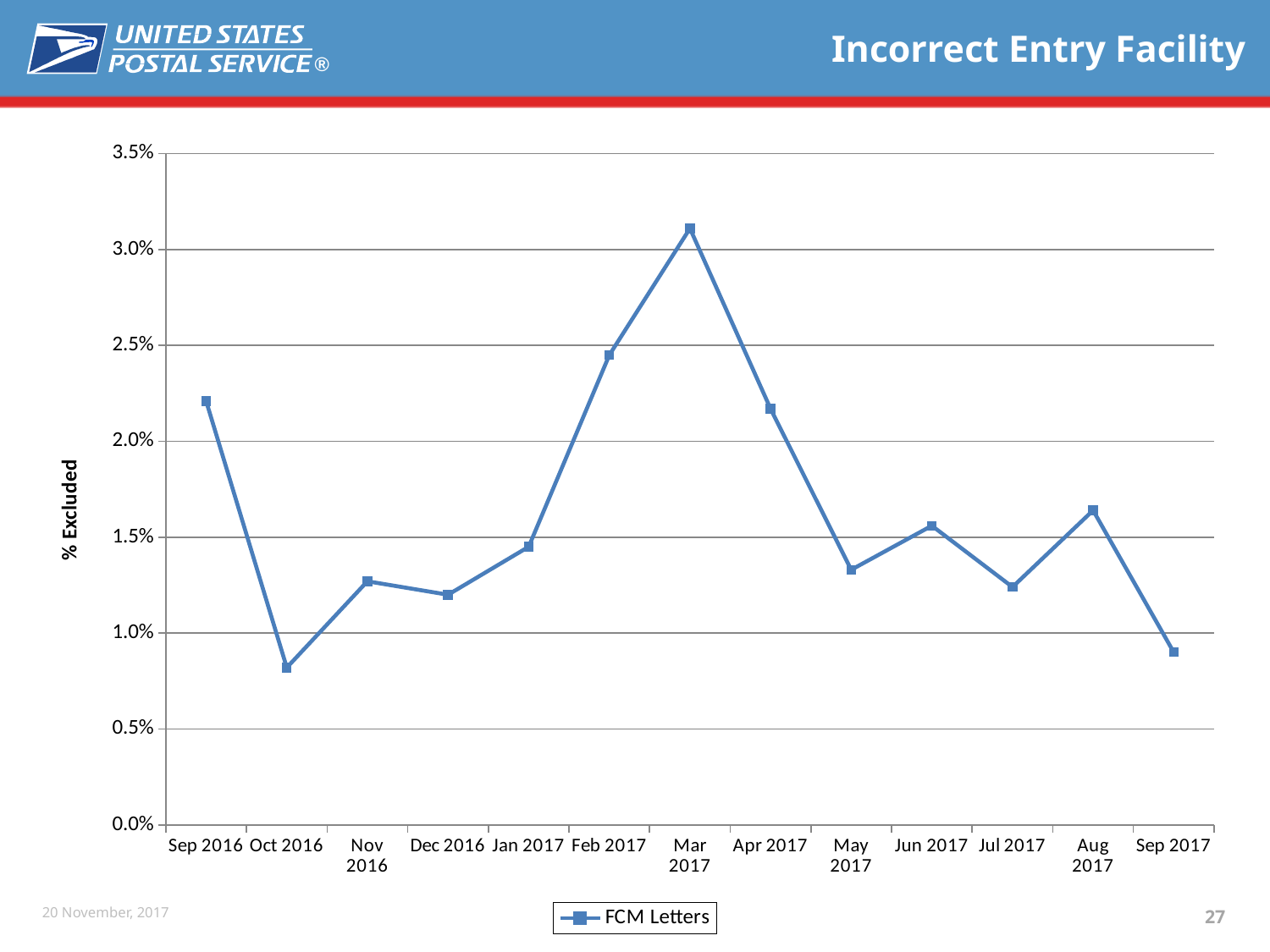
Which is larger, the value for Feb 2017 or the value for Apr 2017? Feb 2017 How many months are plotted on the x axis? 13 Which month has the highest value for FCM Letters? Mar 2017 Does the value rise or fall from Mar 2017 to May 2017? Fall How many series does the legend list? 1 What kind of chart is shown on the slide? Line chart Is the value for Jul 2017 greater or less than 1.5%? less Which month has the lowest value for FCM Letters? Oct 2016 Is the value for Feb 2017 greater or less than 2.0%? greater Is the value for Mar 2017 greater or less than 3.0%? greater Which is larger, the value for Sep 2016 or the value for Sep 2017? Sep 2016